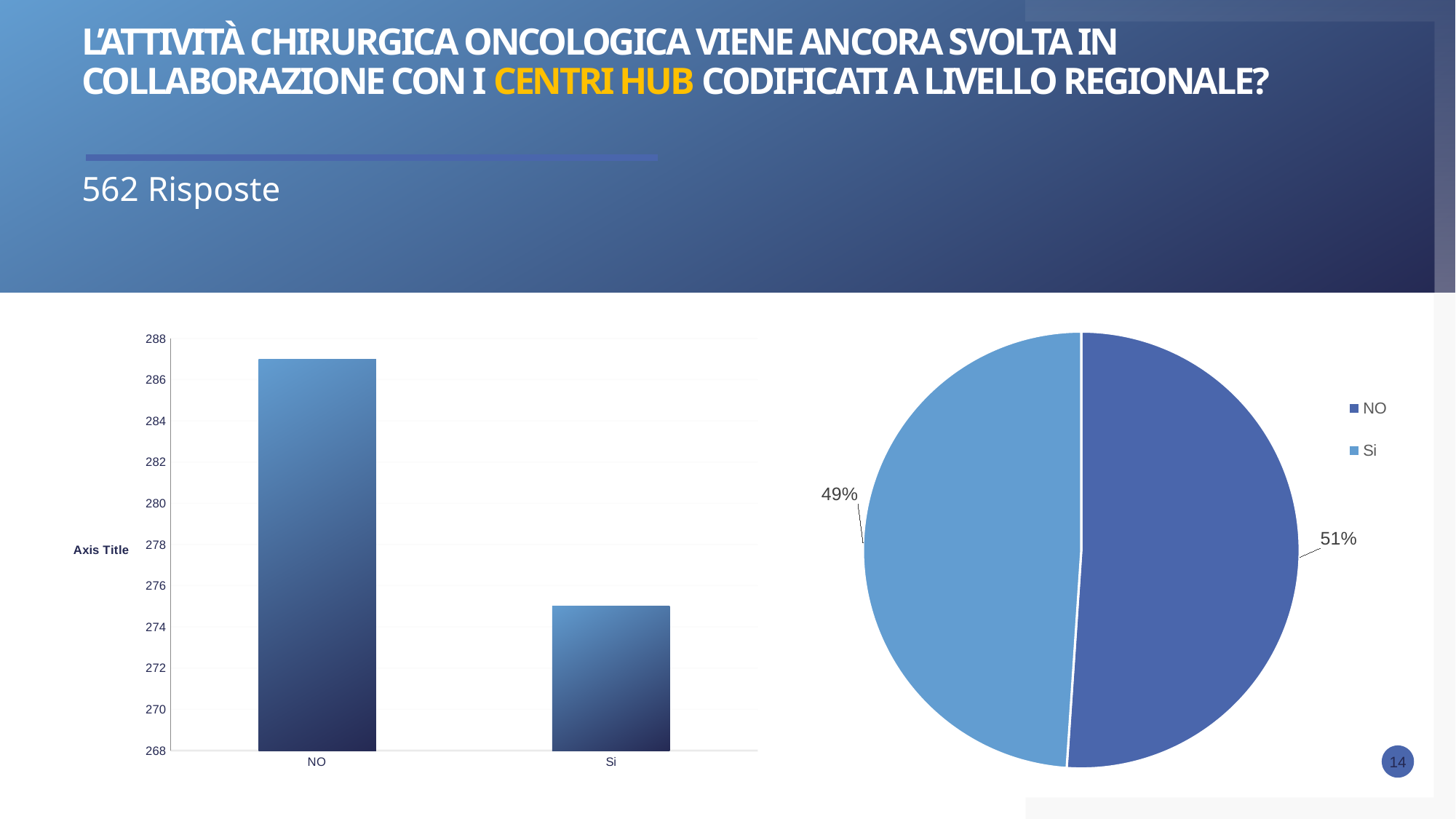
On the pie chart on the right, what is the difference between the NO share and the Si share? 2% On the pie chart on the right, what share is labelled for NO? 51% What kind of chart is shown on the right of the slide? pie chart What kind of chart is shown on the left of the slide? bar chart On the pie chart on the right, what share is labelled for Si? 49% On the bar chart on the left, how many categories are shown on the x axis? 2 On the bar chart on the left, which category has the taller bar? NO On the bar chart on the left, is the value for Si greater or less than 280? less How many entries does the legend of the pie chart on the right list? 2 On the bar chart on the left, is the value for Si greater or less than 270? greater On the bar chart on the left, which category has the shorter bar? Si On the bar chart on the left, is the value for NO greater or less than 280? greater